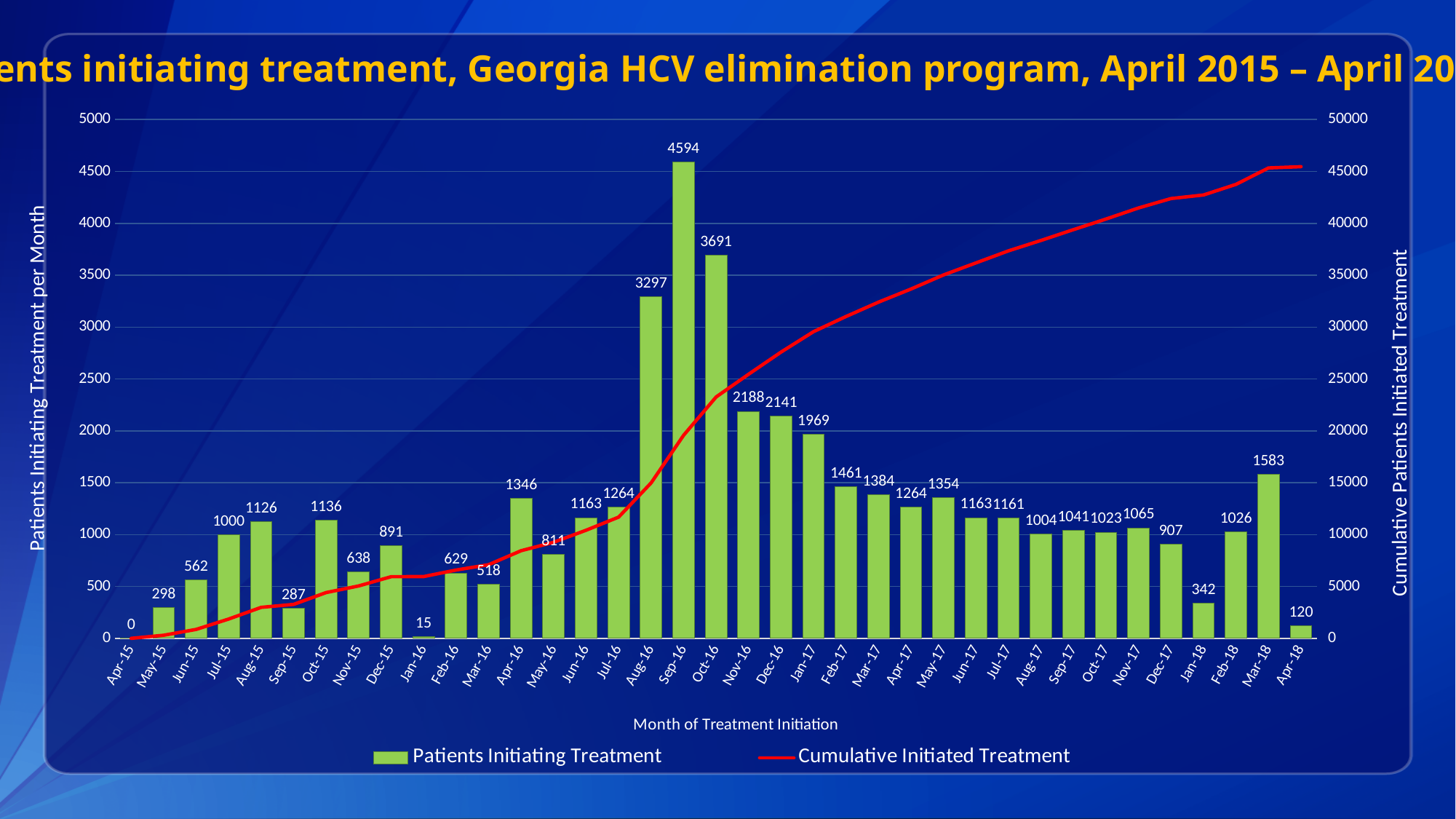
How many patients initiated treatment in Jan-16? 15 Which month had more patients initiating treatment, Nov-16 or Jan-17? Nov-16 Which month has the highest number of patients initiating treatment? Sep-16 How many series does the legend list? 2 Does the Cumulative Initiated Treatment line rise or fall from Apr-15 to Apr-18? rise Is the Cumulative Initiated Treatment value for Dec-16 greater or less than 25000? greater How many patients initiated treatment in Sep-16? 4594 Which month has the lowest number of patients initiating treatment? Apr-15 What is the difference between the number of patients initiating treatment in Sep-16 and Oct-16? 903 What colour are the Patients Initiating Treatment bars? Green How many months are shown on the x axis? 37 What is the value of the Patients Initiating Treatment bar for Mar-18? 1583